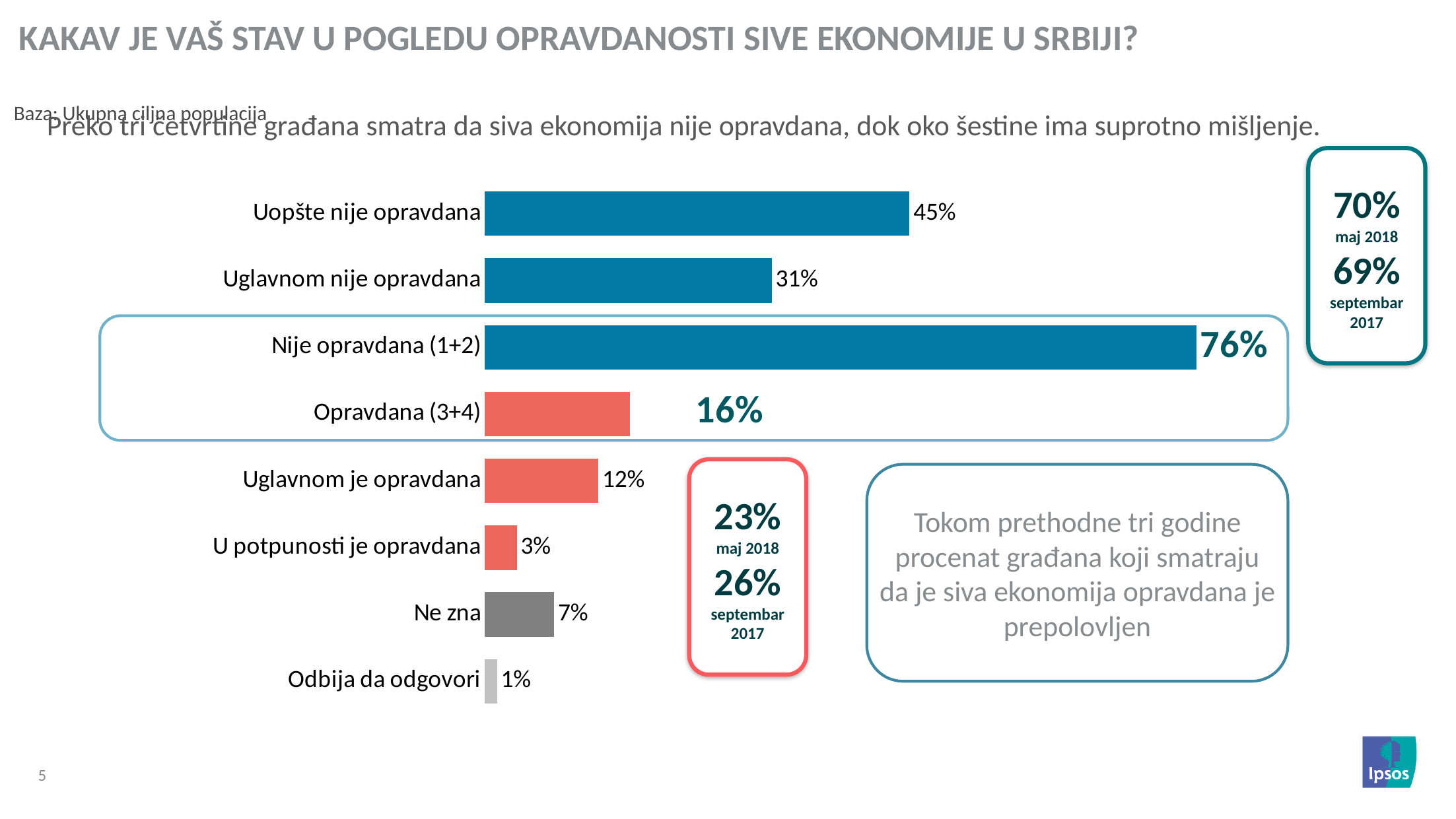
How many categories are shown in the bar chart? 8 Which category has the lowest value in the chart? Odbija da odgovori What is the value for "Nije opravdana (1+2)"? 76% What is the value for "Uglavnom nije opravdana"? 31% What is the value for "Opravdana (3+4)"? 16% What is the value for "Ne zna"? 7% Which is larger, "Uglavnom je opravdana" or "Ne zna"? Uglavnom je opravdana What kind of chart is shown on the slide? Bar chart What colour are the bars for the "opravdana" (justified) categories? Red What is the difference between "Nije opravdana (1+2)" and "Opravdana (3+4)"? 60 percentage points Which category has the highest value in the chart? Nije opravdana (1+2) What is the value for "Uopšte nije opravdana"? 45%